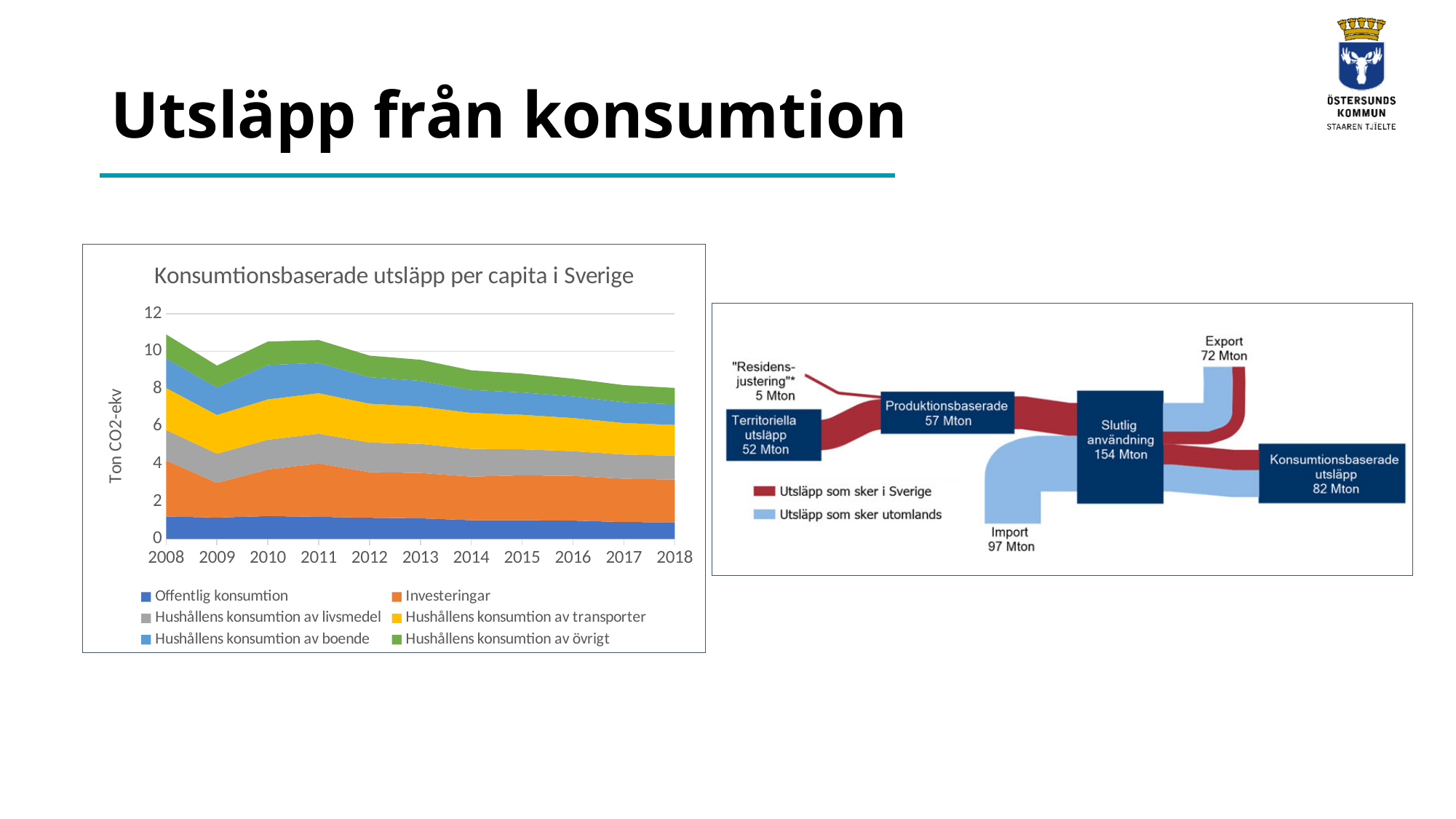
In the right flow diagram, what is the value shown for Import? 97 Mton What is the y-axis label of the left chart "Konsumtionsbaserade utsläpp per capita i Sverige"? Ton CO2-ekv In the left chart "Konsumtionsbaserade utsläpp per capita i Sverige", is the total value for 2008 greater or less than 10? greater In the right flow diagram, what is the difference between Import and Export? 25 Mton In the right flow diagram, what is the value shown for Konsumtionsbaserade utsläpp? 82 Mton How many series does the legend of the left chart "Konsumtionsbaserade utsläpp per capita i Sverige" list? 6 What kind of chart is the left chart titled "Konsumtionsbaserade utsläpp per capita i Sverige"? Stacked area chart In the left chart "Konsumtionsbaserade utsläpp per capita i Sverige", is the total value for 2018 greater or less than 10? less In the right flow diagram, which colour represents "Utsläpp som sker i Sverige"? Red In the left chart "Konsumtionsbaserade utsläpp per capita i Sverige", do the total emissions per capita rise or fall from 2008 to 2018? Fall In the right flow diagram, which node has the largest value? Slutlig användning (154 Mton) In the left chart "Konsumtionsbaserade utsläpp per capita i Sverige", how many years are shown on the x axis? 11